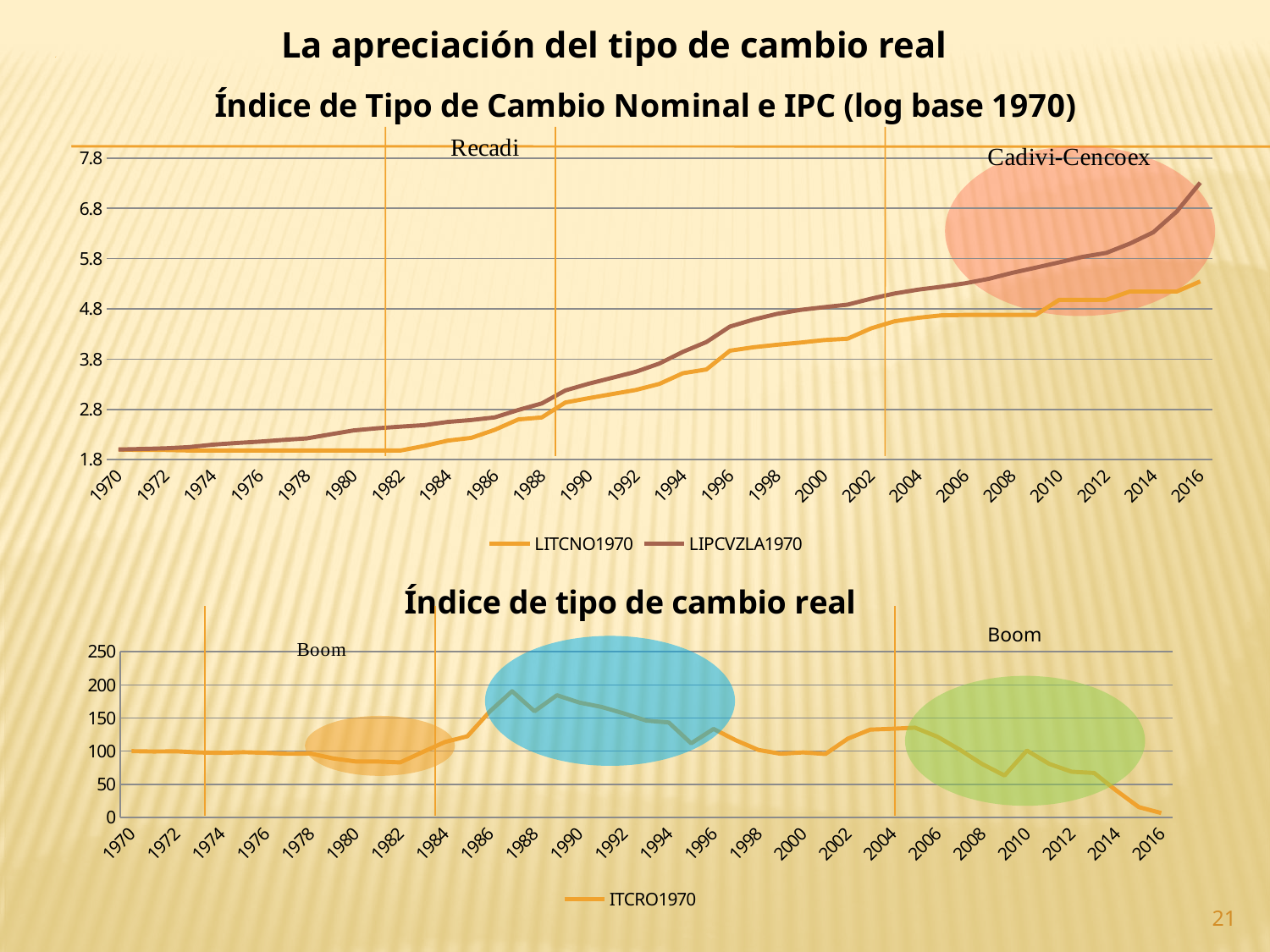
What are the two series named in the legend of the top chart? LITCNO1970 and LIPCVZLA1970 What kind of chart is the top chart titled 'Índice de Tipo de Cambio Nominal e IPC (log base 1970)'? line chart In the bottom chart, in which year does ITCRO1970 reach its lowest value? 2016 In the top chart, is the value of LITCNO1970 in 2016 greater or less than 5.8? less What is the name of the series shown in the bottom chart 'Índice de tipo de cambio real'? ITCRO1970 How many series does the legend of the top chart list? 2 In the bottom chart, is the value of ITCRO1970 in 1988 greater or less than 150? greater In the top chart, is the value of LIPCVZLA1970 in 2016 greater or less than 6.8? greater In the bottom chart, do the values of ITCRO1970 rise or fall from 2010 to 2016? fall In the top chart, do the values of LIPCVZLA1970 rise or fall from 1970 to 2016? rise In the top chart, which series has the higher value in 2016, LITCNO1970 or LIPCVZLA1970? LIPCVZLA1970